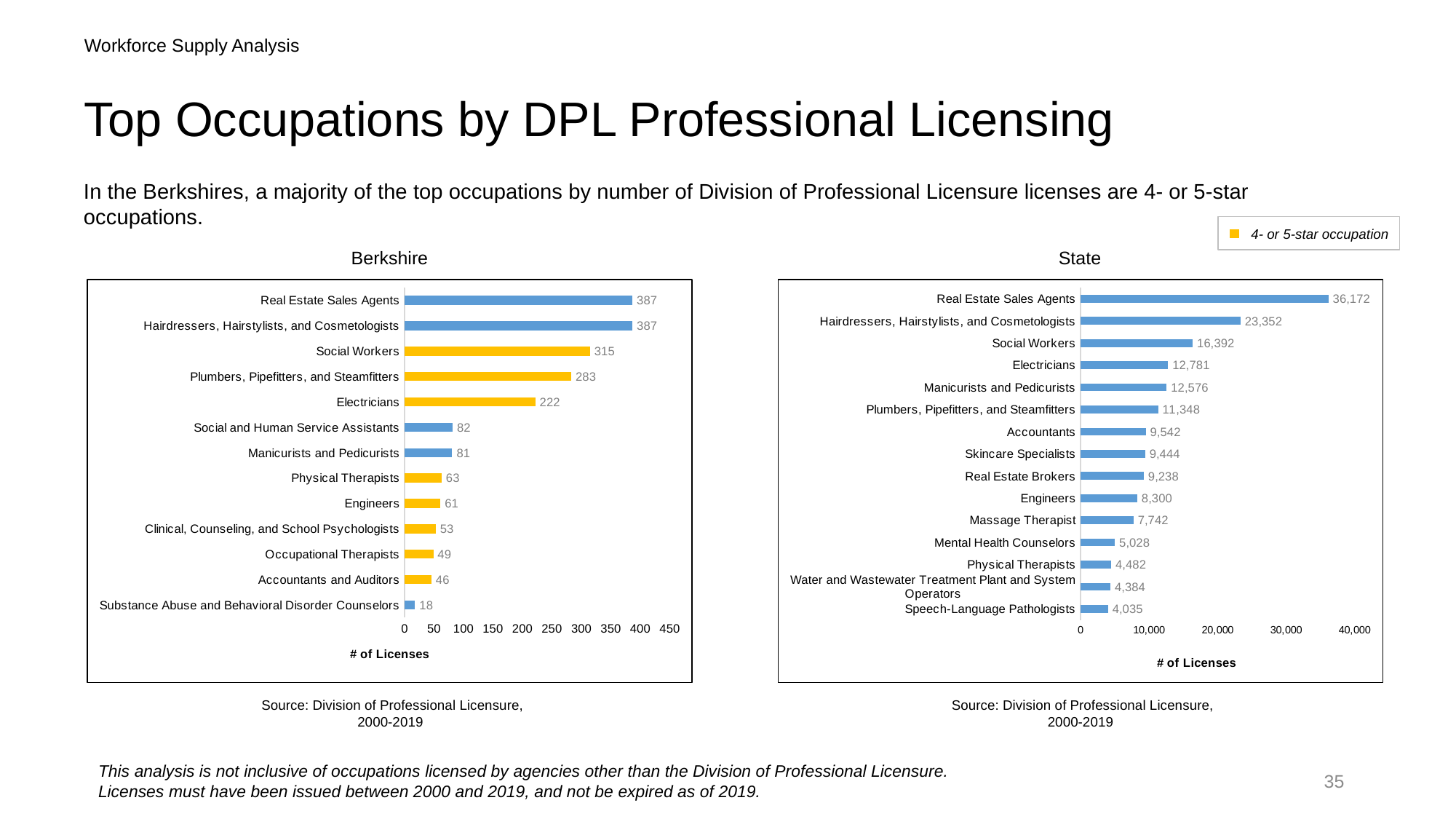
In the Berkshire chart, what is the difference in licenses between Plumbers, Pipefitters, and Steamfitters and Electricians? 61 What type of chart is the State chart? Bar chart In the Berkshire chart, which has more licenses, Physical Therapists or Engineers? Physical Therapists In the Berkshire chart, how many licenses are shown for Social Workers? 315 According to the legend, what do the yellow bars in the Berkshire chart represent? 4- or 5-star occupation In the Berkshire chart, how many occupations are listed? 13 In the State chart, which occupation has the lowest number of licenses? Speech-Language Pathologists In the State chart, what is the difference in licenses between Real Estate Sales Agents and Hairdressers, Hairstylists, and Cosmetologists? 12,820 In the State chart, how many licenses are shown for Electricians? 12,781 In the State chart, which occupation has the highest number of licenses? Real Estate Sales Agents In the Berkshire chart, which occupation has the lowest number of licenses? Substance Abuse and Behavioral Disorder Counselors In the State chart, how many occupations are listed? 15